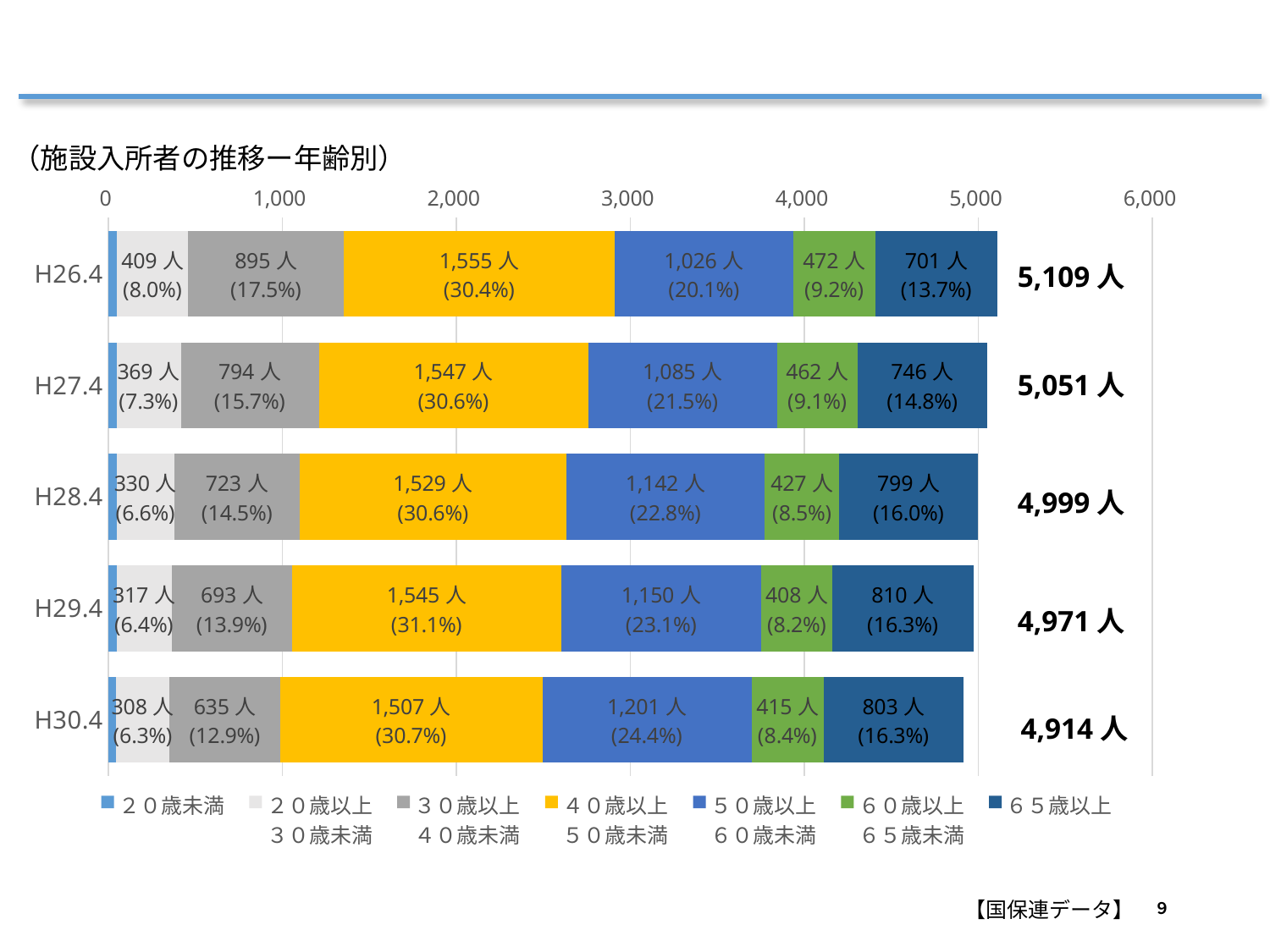
What type of chart is shown on the slide? Stacked bar chart How many time periods (categories) are plotted on the chart? 5 What is the total number of residents shown for H28.4? 4,999人 Which period has the highest total number of residents? H26.4 Which is larger in H27.4: the 30歳以上40歳未満 value or the 65歳以上 value? 30歳以上40歳未満 What percentage share does 50歳以上60歳未満 have in H29.4? 23.1% What is the difference between the 20歳以上30歳未満 values for H26.4 and H30.4? 101人 Which period has the lowest total number of residents? H30.4 What is the value for 40歳以上50歳未満 in H26.4? 1,555人 What is the value for 65歳以上 in H30.4? 803人 Do the total numbers of residents rise or fall from H26.4 to H30.4? Fall How many series does the legend list? 7